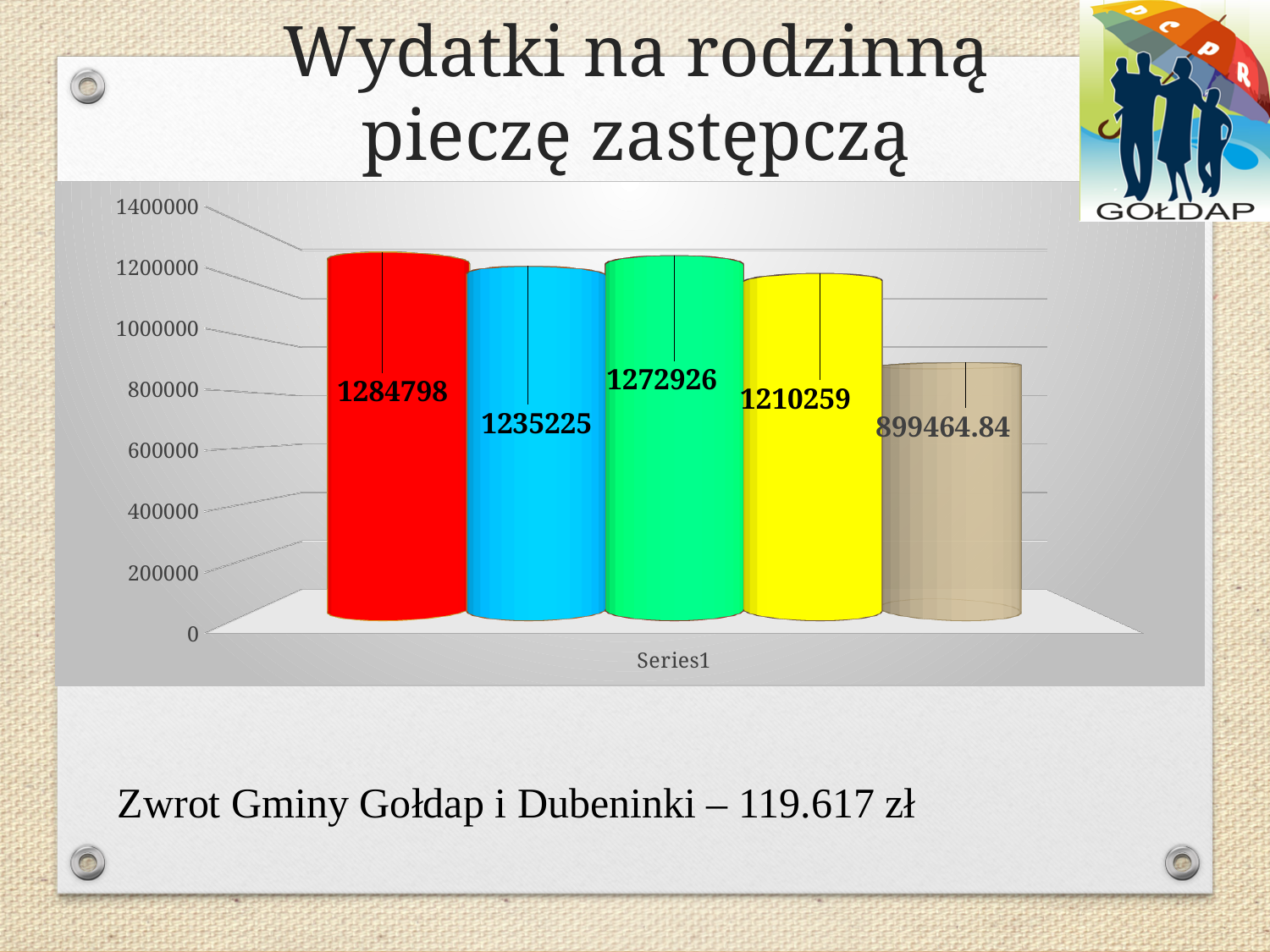
How many bars are shown in the chart? 5 What is the value shown on the rightmost (tan) bar? 899464.84 Which is larger, the blue bar or the yellow bar? The blue bar What is the value shown on the blue bar? 1235225 What is the difference between the red bar and the green bar? 11872 What is the value shown on the red bar? 1284798 What is the value shown on the yellow bar? 1210259 Which bar has the highest value? The red bar (1284798) Is the value of the tan (rightmost) bar greater or less than 1000000? less Which bar has the lowest value? The tan (rightmost) bar (899464.84) What is the title of the slide containing the chart? Wydatki na rodzinną pieczę zastępczą What is the value shown on the green bar? 1272926